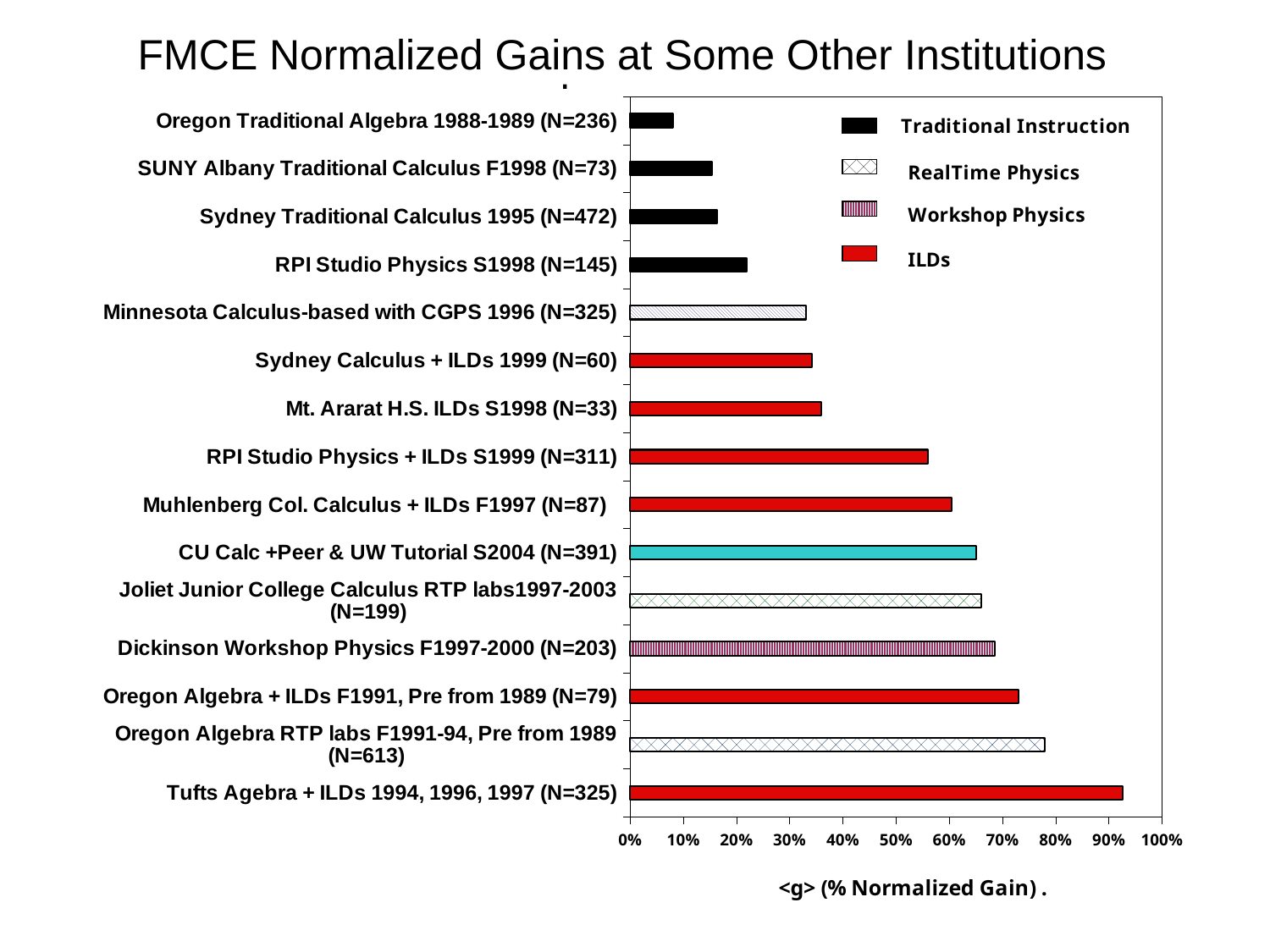
Which has the larger normalized gain: Sydney Traditional Calculus 1995 (N=472) or Sydney Calculus + ILDs 1999 (N=60)? Sydney Calculus + ILDs 1999 (N=60) Which category has the highest normalized gain? Tufts Agebra + ILDs 1994, 1996, 1997 (N=325) Is the value for Tufts Agebra + ILDs 1994, 1996, 1997 (N=325) greater or less than 90%? greater Is the value for Mt. Ararat H.S. ILDs S1998 (N=33) greater or less than 40%? less Is the value for RPI Studio Physics + ILDs S1999 (N=311) greater or less than 50%? greater What is the title of the horizontal axis? <g> (% Normalized Gain) Which has the larger normalized gain: RPI Studio Physics S1998 (N=145) or RPI Studio Physics + ILDs S1999 (N=311)? RPI Studio Physics + ILDs S1999 (N=311) Which category has the lowest normalized gain? Oregon Traditional Algebra 1988-1989 (N=236) How many entries does the legend list? 4 How many institution categories are plotted on the chart? 15 What kind of chart is shown on the slide? bar chart